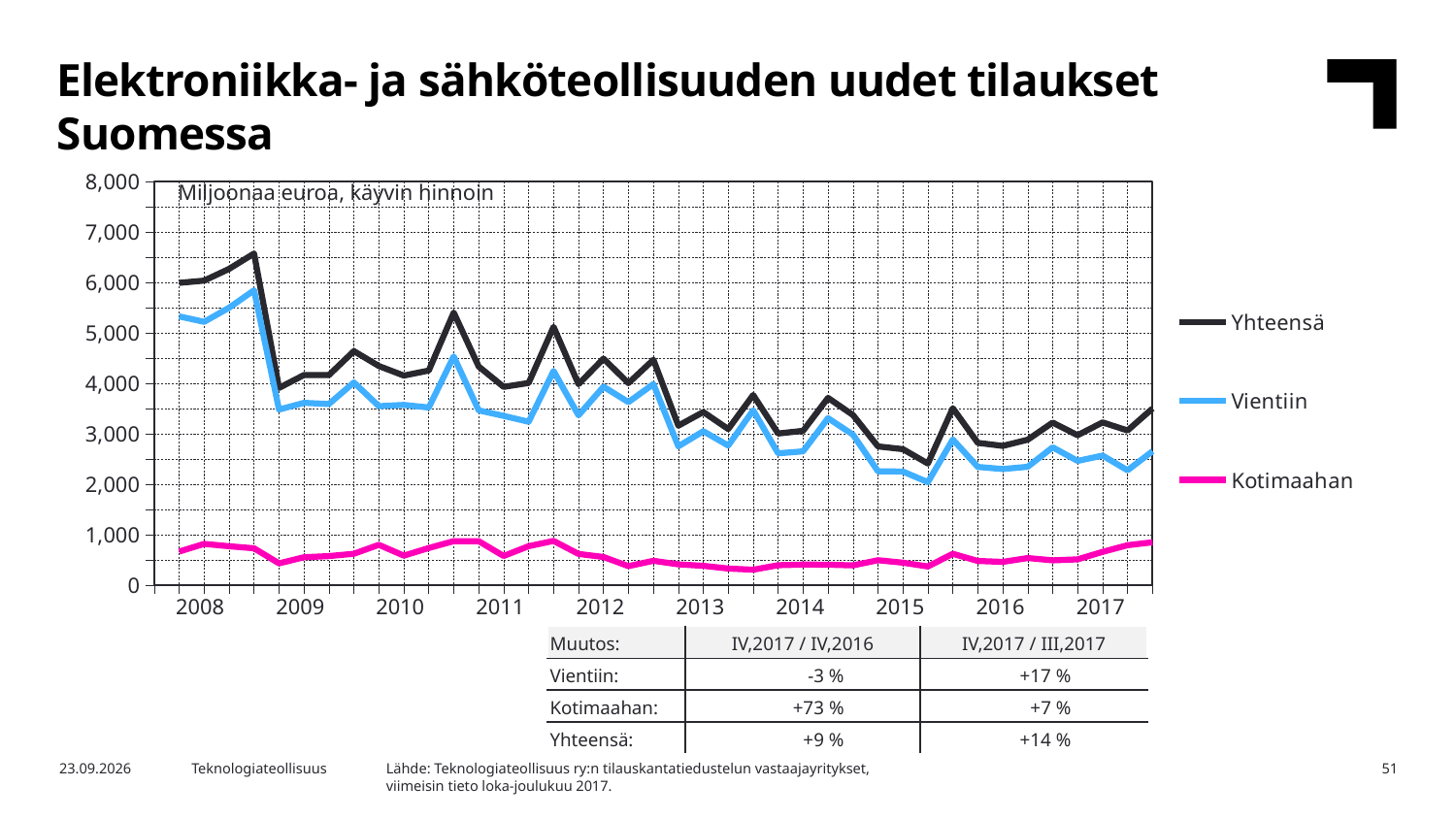
What are the three series named in the legend? Yhteensä, Vientiin, Kotimaahan Which series has the highest values throughout the chart? Yhteensä How many series does the legend list? 3 Is the value for Vientiin at the start of 2008 greater or less than 5,000? greater How many years are labelled on the x axis? 10 What kind of chart is shown on the slide? line chart Which series has the lowest values throughout the chart? Kotimaahan Which series is larger in 2016, Vientiin or Kotimaahan? Vientiin Is the value for Kotimaahan in 2017 greater or less than 1,000? less Does the Yhteensä series overall rise or fall from 2008 to 2017? fall Is the peak value of Yhteensä in 2008 greater or less than 6,000? greater What unit is stated in the label inside the chart area? Miljoonaa euroa, käyvin hinnoin